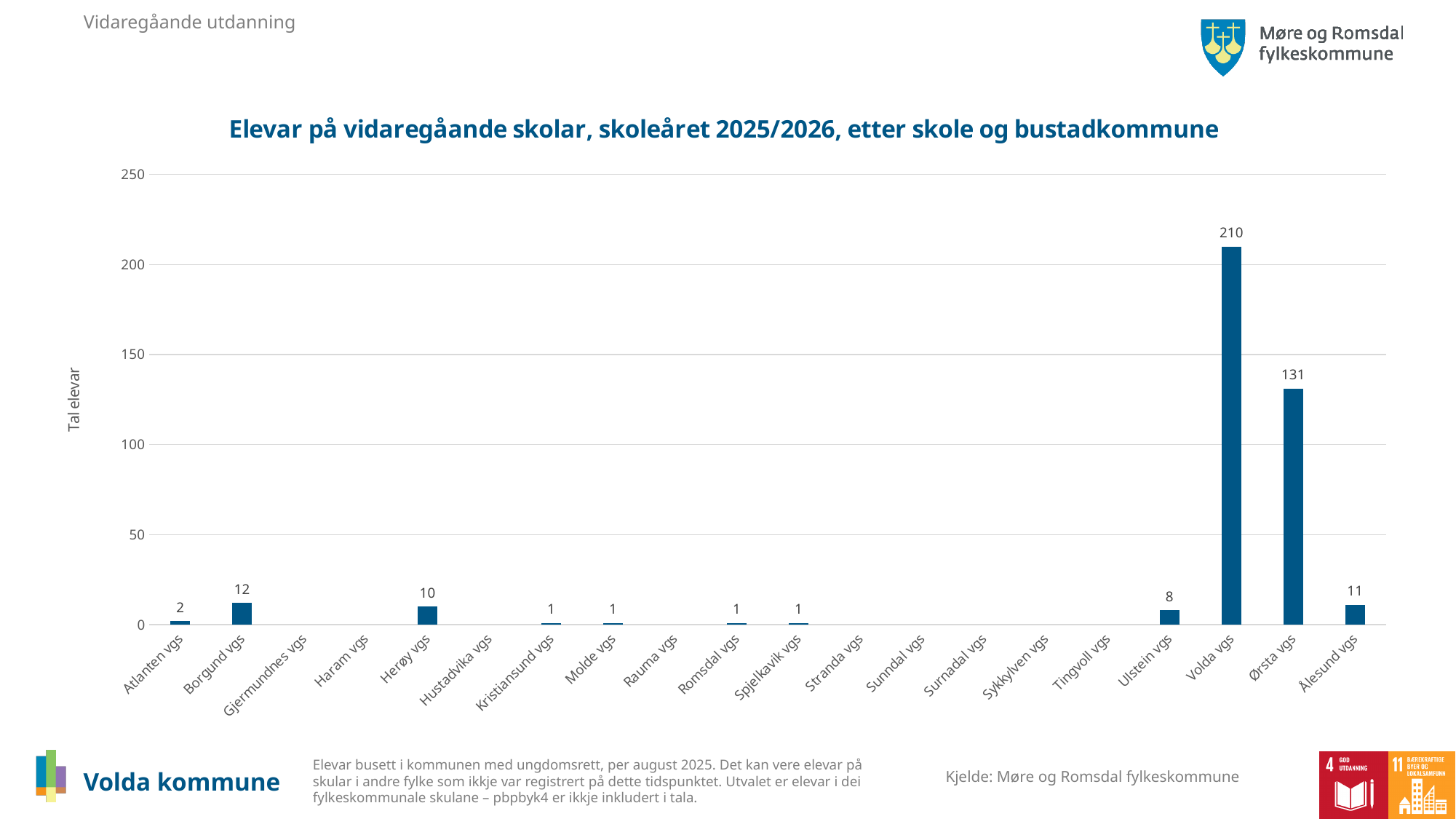
Is the value for Ørsta vgs greater or less than 100? greater How many students are shown for Volda vgs? 210 What is the difference between the values for Borgund vgs and Herøy vgs? 2 How many schools are listed on the x axis? 20 What is the value for Ørsta vgs? 131 What is the value for Ulstein vgs? 8 Which is larger, the value for Herøy vgs or the value for Ålesund vgs? Ålesund vgs What is the label of the y axis? Tal elevar What kind of chart is shown on the slide? bar chart Which school has the highest number of students? Volda vgs What is the difference between the values for Volda vgs and Ørsta vgs? 79 What is the value for Borgund vgs? 12